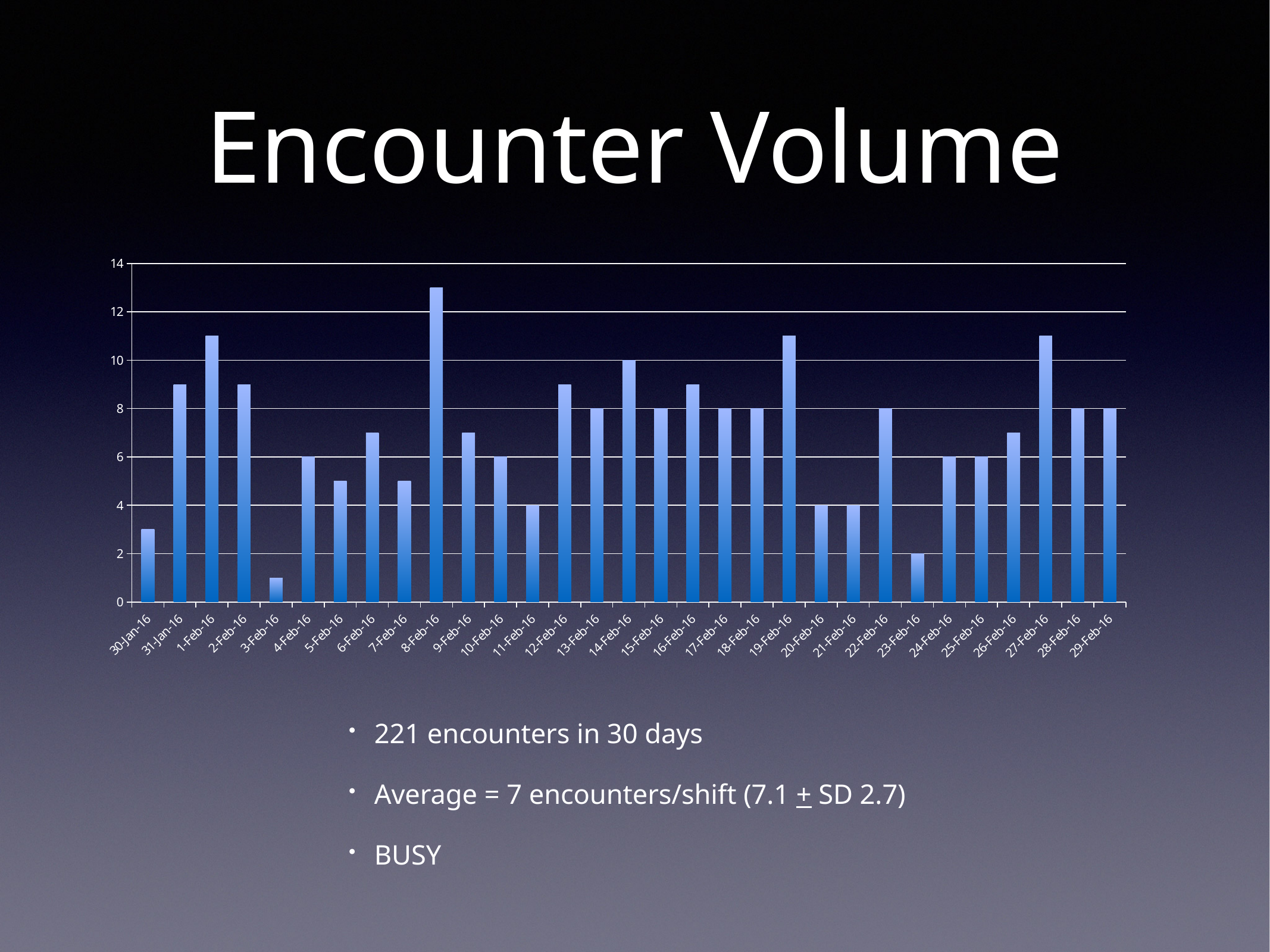
What is the title of the chart on the slide? Encounter Volume What is the value for 14-Feb-16? 10 Is the value for 8-Feb-16 greater or less than 12? greater What is the value for 13-Feb-16? 8 Which date has the lowest encounter volume? 3-Feb-16 Which date has the highest encounter volume? 8-Feb-16 Is the value for 30-Jan-16 greater or less than 4? less What is the difference between the values for 14-Feb-16 and 23-Feb-16? 8 What type of chart is shown on the slide? Bar chart What is the value for 23-Feb-16? 2 What is the value for 11-Feb-16? 4 How many dates are plotted on the x axis? 31